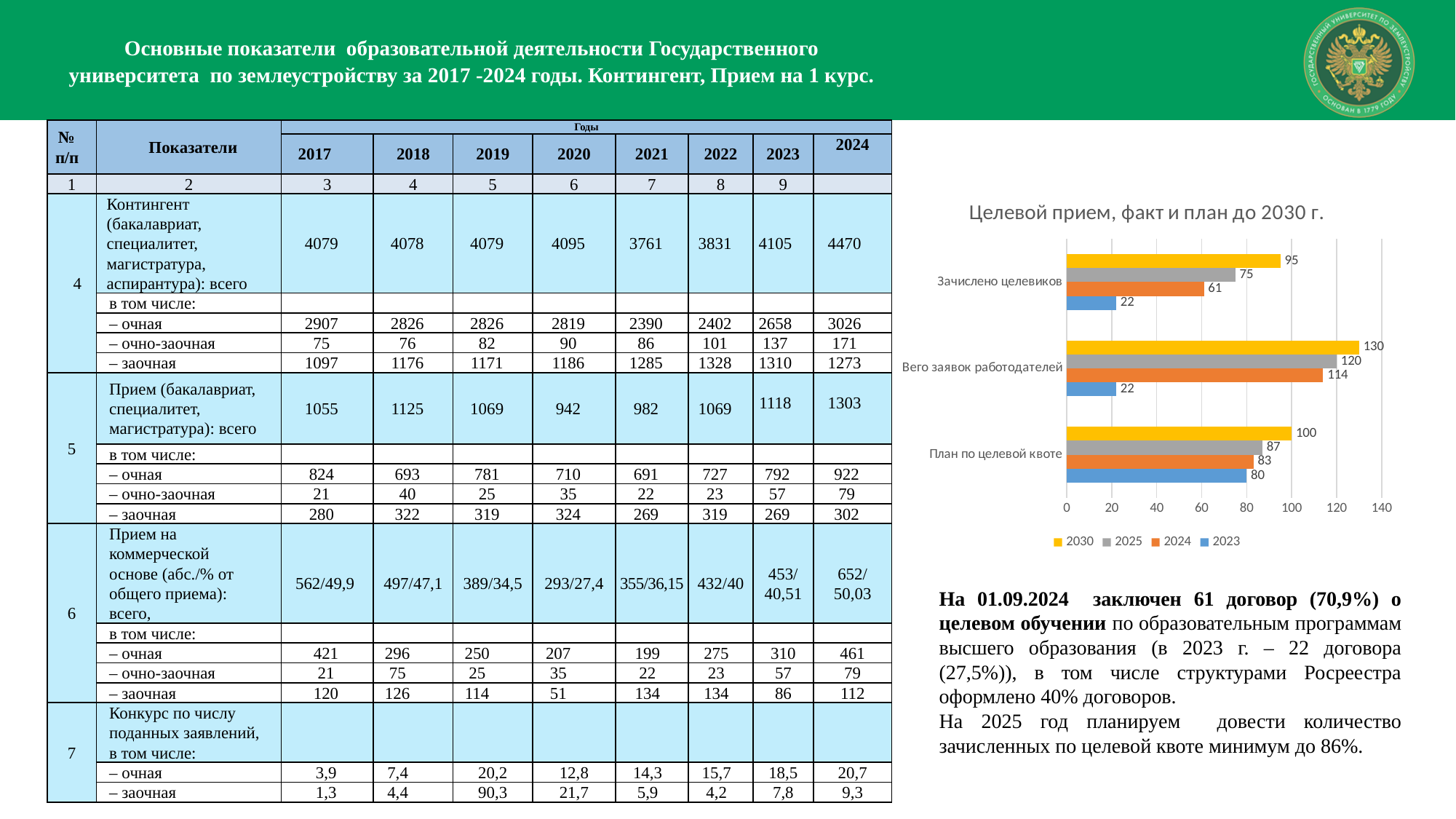
How many categories are shown on the chart? 3 What kind of chart is shown on the slide? bar chart Which series has the lowest value for Зачислено целевиков? 2023 What is the difference between the 2025 and 2024 values for Зачислено целевиков? 14 What is the 2023 value for План по целевой квоте? 80 How many series does the chart legend list? 4 Which is larger for План по целевой квоте: the 2025 value or the 2024 value? 2025 What is the title of the chart on the slide? Целевой прием, факт и план до 2030 г. What is the 2030 value for Зачислено целевиков? 95 Which series has the highest value for Вего заявок работодателей? 2030 What is the 2024 value for Вего заявок работодателей? 114 Which series is shown in orange in the chart legend? 2024